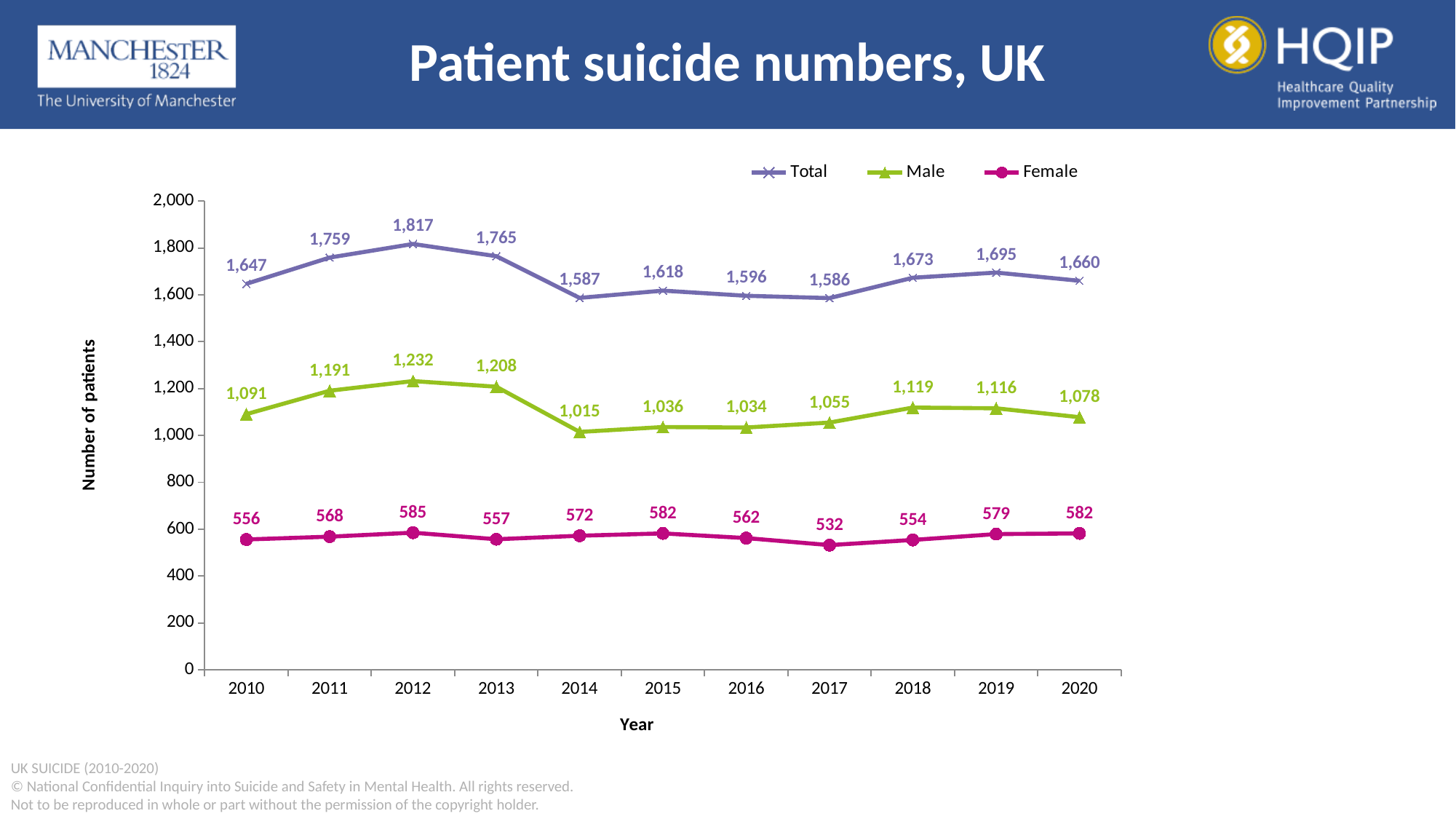
Is the Male value for 2012 greater or less than 1,200? greater What is the Female value for 2017? 532 In which year is the Female series lowest? 2017 What is the Male value for 2014? 1,015 In which year is the Total series highest? 2012 What kind of chart is shown on the slide? line chart How many series does the legend list? 3 How many years are shown on the x axis? 11 What is the Total value for 2012? 1,817 What is the label of the y axis? Number of patients Which is larger, the Total value for 2011 or the Total value for 2013? 2013 What is the difference between the Male and Female values in 2020? 496